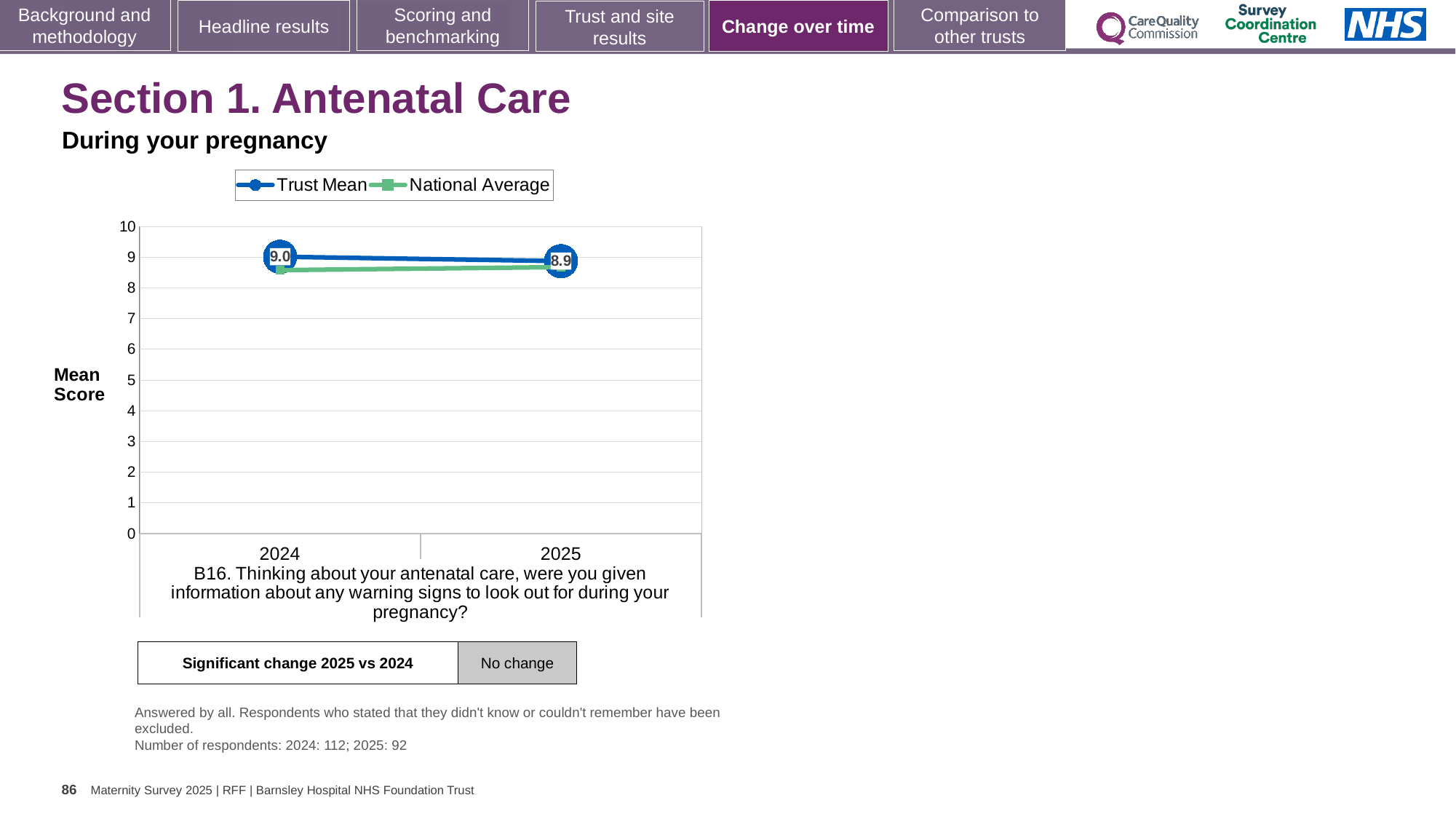
Is the National Average value for 2024 greater or less than 8? greater In which year is the Trust Mean higher? 2024 What is the label on the y axis of the chart? Mean Score In 2024, which is larger: the Trust Mean or the National Average? Trust Mean What is the Trust Mean value for 2024? 9.0 What is the Trust Mean value for 2025? 8.9 Is the National Average value for 2025 greater or less than 9? less Does the Trust Mean rise or fall from 2024 to 2025? fall How many years are plotted on the x axis? 2 What is the difference between the Trust Mean in 2024 and in 2025? 0.1 How many series does the legend list? 2 What kind of chart is shown on the slide? line chart